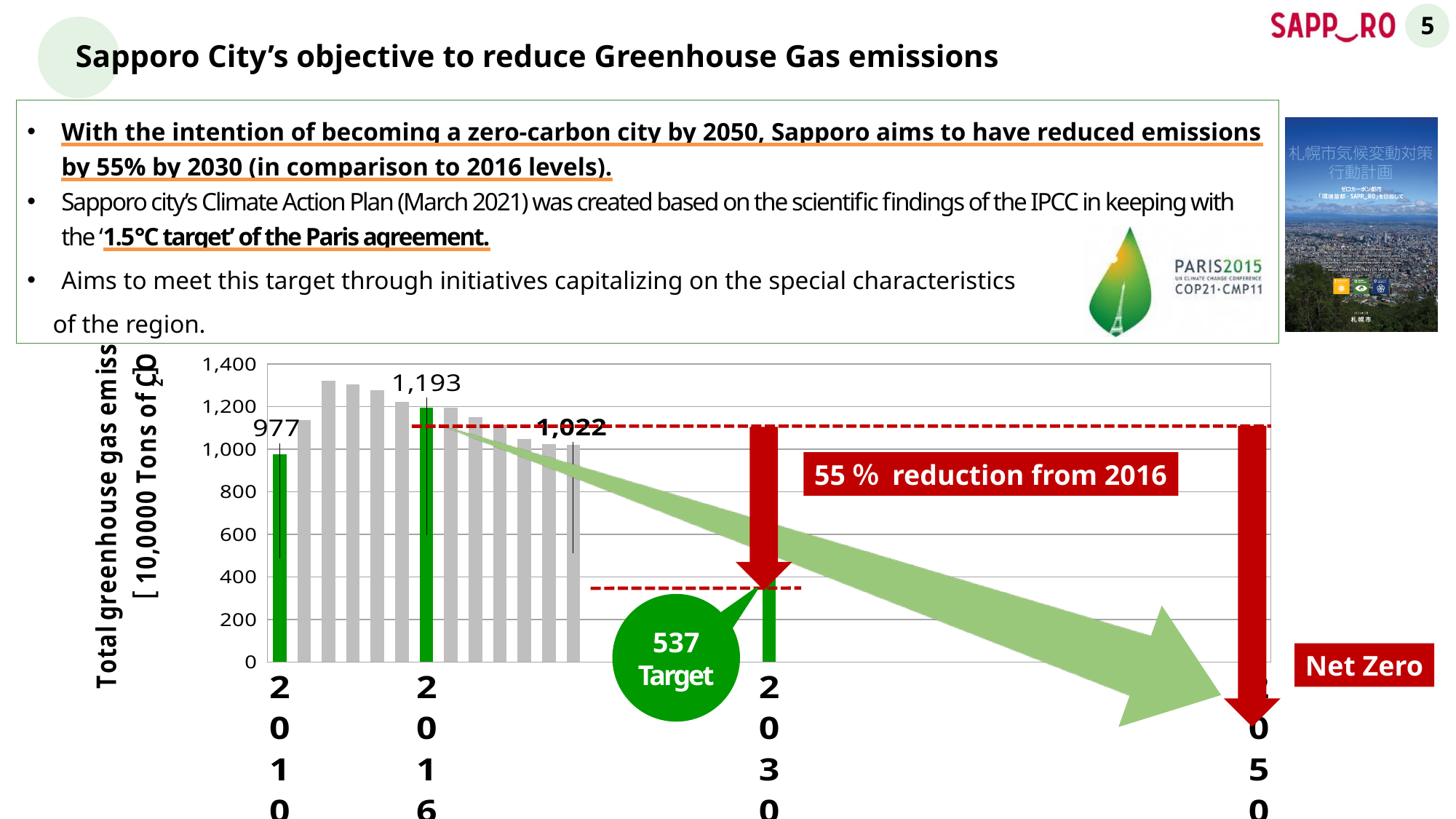
What is the total greenhouse gas emissions value shown for 2016? 1,193 Do the emissions values rise or fall from 2016 onward along the x axis? fall Is the value for 2010 greater or less than 1,000? less What is the difference between the 2016 value and the 2010 value? 216 What is the total greenhouse gas emissions value shown for 2010? 977 By how much is the 2030 target lower than the 2016 value? 656 Which year has the higher emissions value, 2010 or 2016? 2016 What percentage reduction from 2016 is indicated for the 2030 target? 55% What kind of chart is used to show the greenhouse gas emissions? bar chart Is the value for 2016 greater or less than 1,000? greater What is the emissions target value shown for 2030? 537 What label is shown for the 2050 goal on the chart? Net Zero